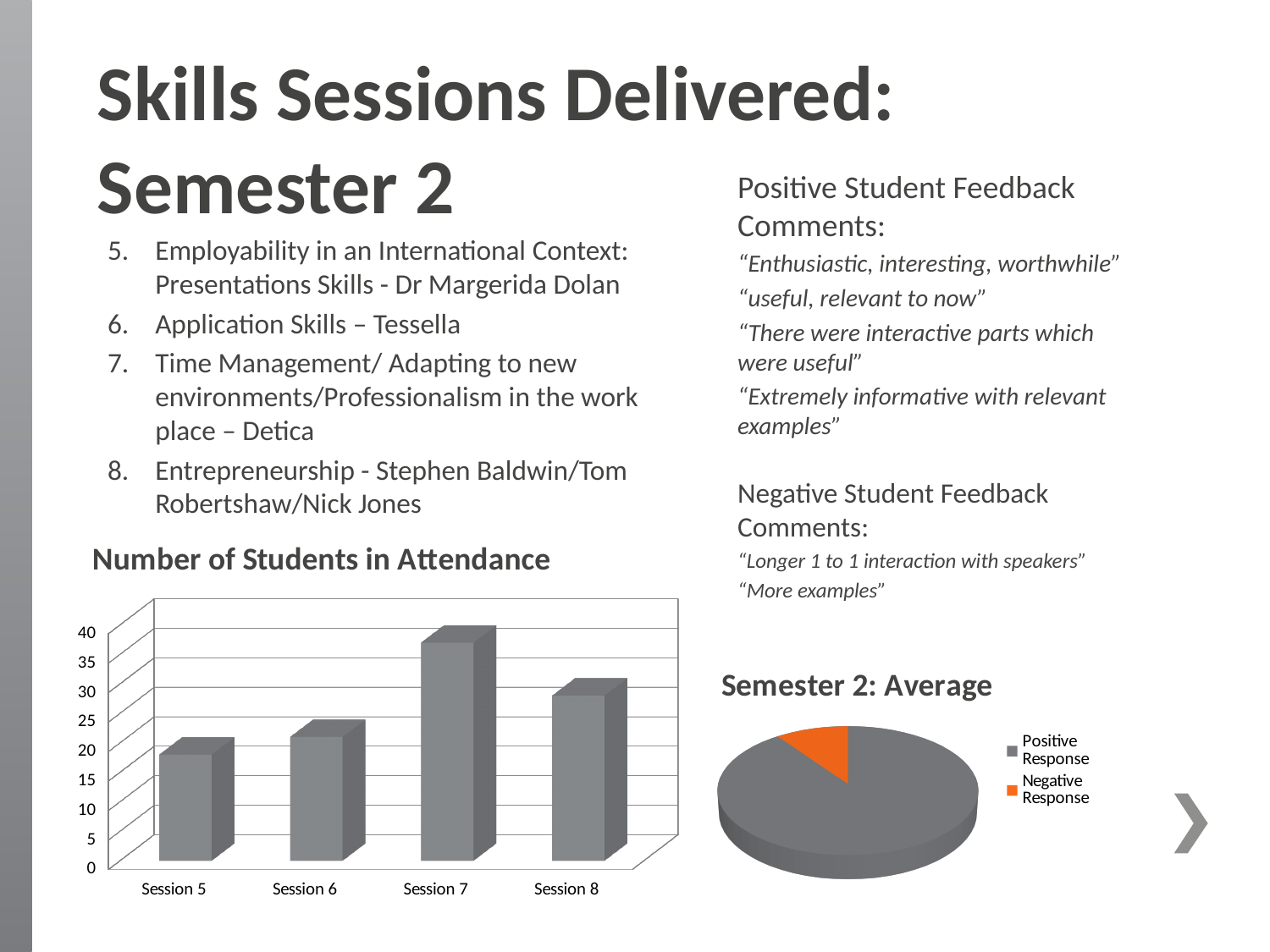
On the 'Number of Students in Attendance' chart, which has more students in attendance, Session 7 or Session 8? Session 7 On the 'Number of Students in Attendance' chart, is the value for Session 8 greater or less than 20? greater On the 'Number of Students in Attendance' chart, is the value for Session 5 greater or less than 25? less On the 'Number of Students in Attendance' chart, is the value for Session 6 greater or less than 30? less On the 'Number of Students in Attendance' chart, which session has the highest attendance? Session 7 On the 'Semester 2: Average' chart, which response type has the larger share? Positive Response On the 'Number of Students in Attendance' chart, which session has the lowest attendance? Session 5 What kind of chart is the 'Number of Students in Attendance' chart? Bar chart How many entries does the legend of the 'Semester 2: Average' chart list? 2 On the 'Number of Students in Attendance' chart, which has more students in attendance, Session 5 or Session 7? Session 7 How many sessions are shown on the 'Number of Students in Attendance' chart? 4